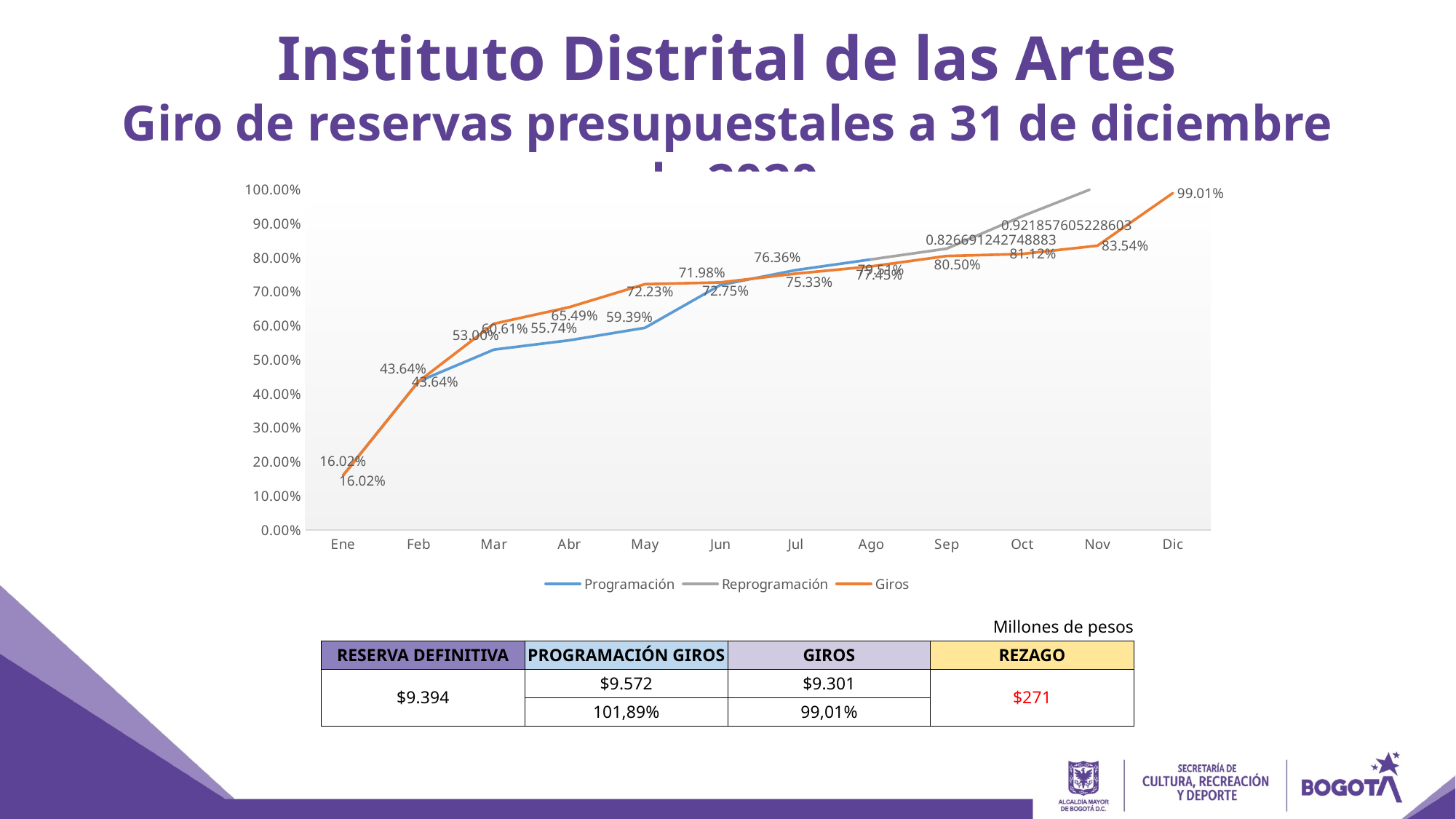
In which month is the Giros series at its lowest? Ene What kind of chart is shown on the slide? line chart How many series does the chart legend list? 3 What is the value shown for Ene? 16.02% In which month is the Giros series at its highest? Dic By how many percentage points does the Giros value for Dic exceed the Giros value for Nov? 15.47 In May, which series has the larger value, Giros or Programación? Giros What is the Giros value for Dic? 99.01% What is the Giros value for Nov? 83.54% How many months are shown along the x axis of the chart? 12 What is the Giros value for Oct? 81.12% What is the Programación value for May? 59.39%